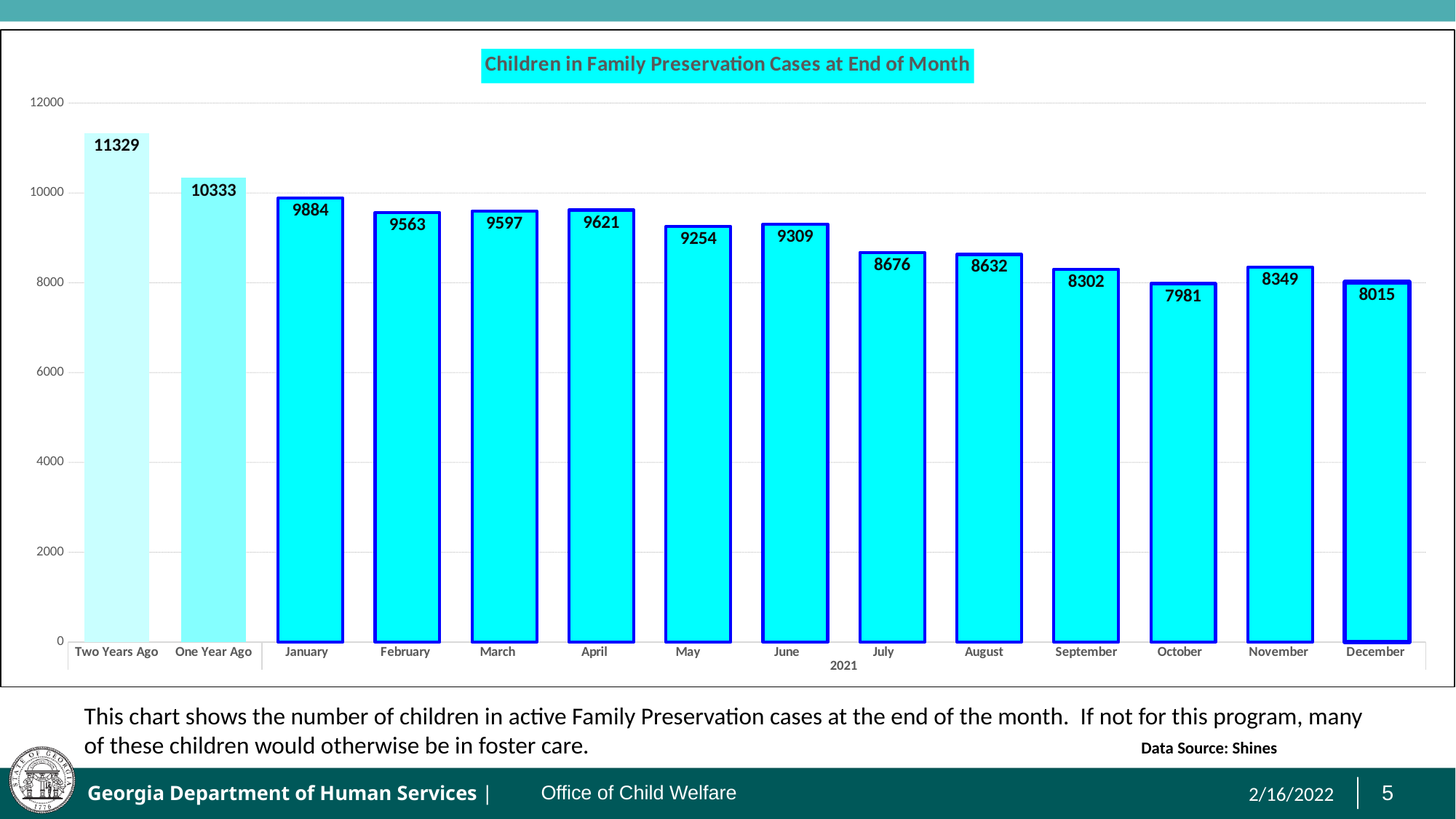
What is the value for October? 7981 What is the difference between the values for Two Years Ago and One Year Ago? 996 What is the value for Two Years Ago? 11329 How many bars are shown in the chart? 14 Which category has the lowest value? October Is the value for July greater or less than 8000? greater What is the value for January? 9884 What is the difference between the values for January and December? 1869 What kind of chart is this? bar chart Which is larger, the value for March or the value for May? March What is the title of the chart? Children in Family Preservation Cases at End of Month Which category has the highest value? Two Years Ago